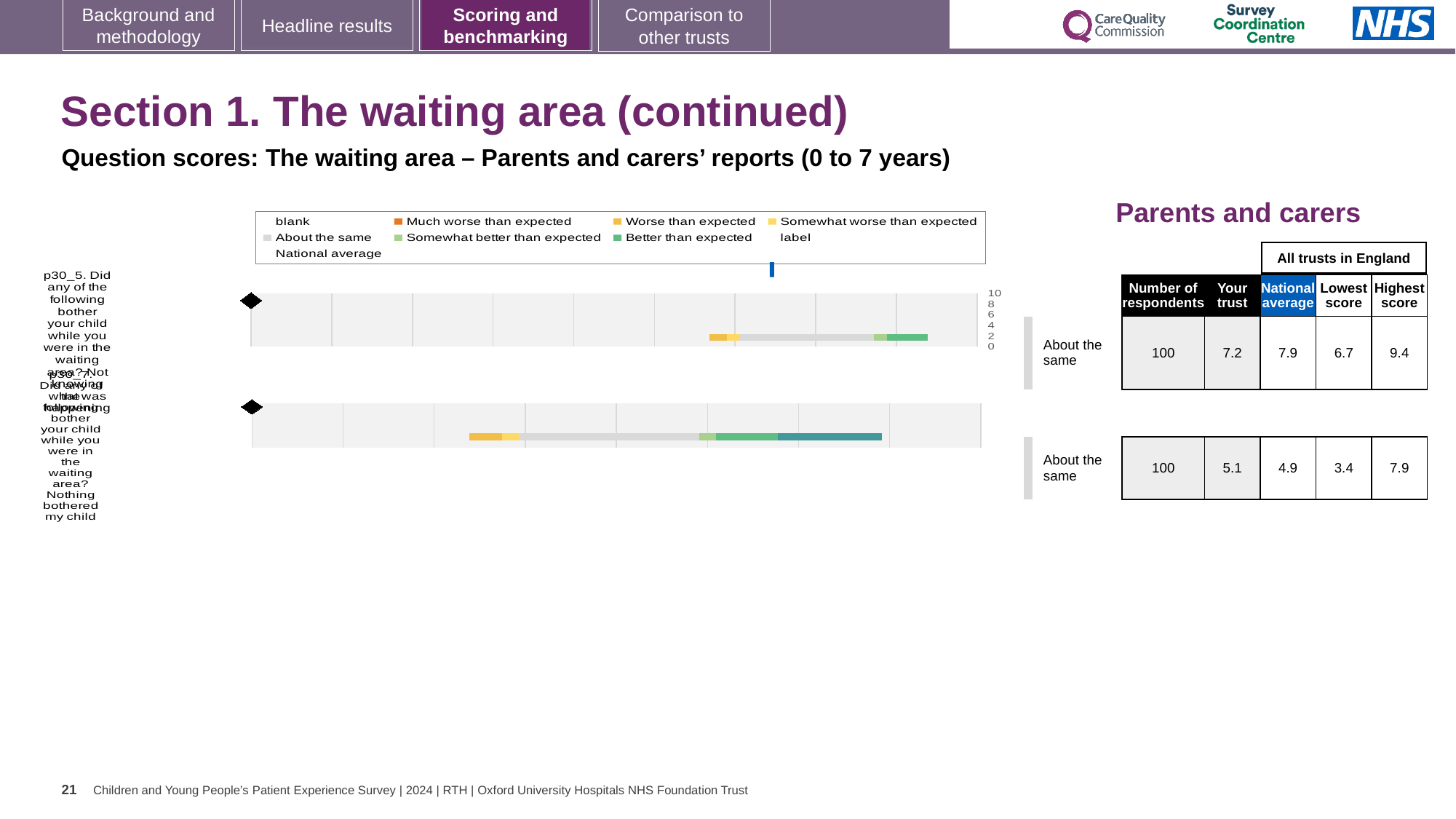
How many question score charts are shown on the slide? 2 For the top chart (p30_5, Not knowing what was happening), what is the national average score shown in the table? 7.9 For the top chart (p30_5), what is the difference between the highest score and the lowest score across all trusts in England? 2.7 For the top chart (p30_5), which is larger: the 'Your trust' score or the national average? National average For the top chart (p30_5, Not knowing what was happening), what is the 'Your trust' score shown in the table? 7.2 For the bottom chart (p30_7), what is the difference between the highest score and the lowest score across all trusts in England? 4.5 For the bottom chart (p30_7, Nothing bothered my child), what is the national average score shown in the table? 4.9 For the bottom chart (p30_7), which is larger: the 'Your trust' score or the national average? Your trust How many entries does the chart legend list? 9 For the bottom chart (p30_7, Nothing bothered my child), what is the 'Your trust' score shown in the table? 5.1 What kind of chart is used on this slide to show the question scores? bar chart What benchmark category label is shown next to both charts? About the same